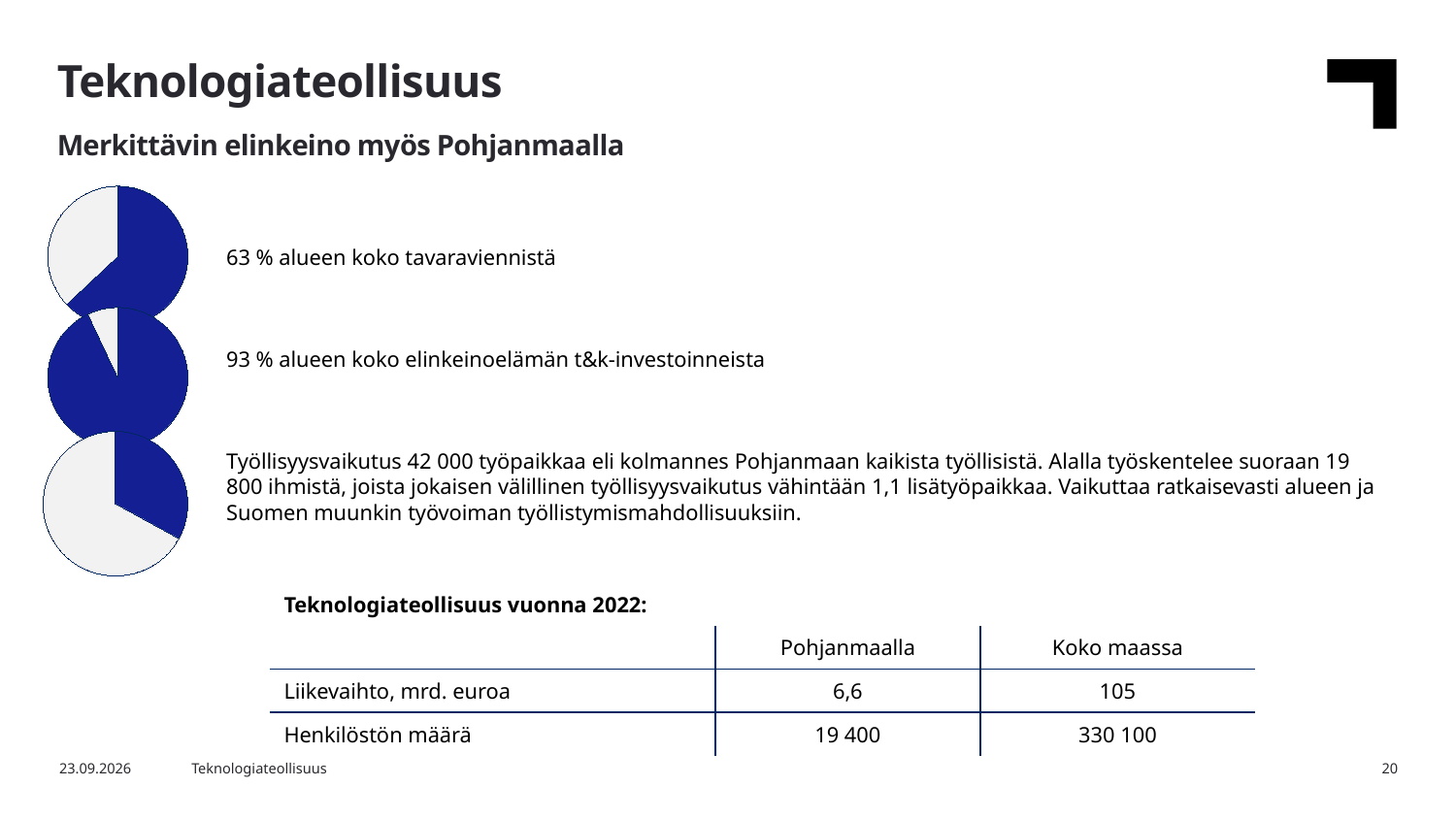
How many slices does each pie chart have? 2 Is the blue slice larger in the top pie chart or in the middle pie chart? The middle pie chart Which pie chart is described by the text about the employment effect of 42 000 jobs? The bottom pie chart What kind of charts are shown on the left side of the slide? Pie charts Is the blue slice larger in the top pie chart or in the bottom pie chart? The top pie chart In the middle pie chart, what share of the region's business R&D investments does the blue slice represent, according to the text beside it? 93 % How many pie charts are on the slide? 3 What is the difference between the blue share in the middle pie chart (93 %) and the blue share in the top pie chart (63 %)? 30 percentage points In the top pie chart, what share of the region's total goods exports does the blue slice represent, according to the text beside it? 63 % Which of the three pie charts has the smallest blue slice? The bottom pie chart Which of the three pie charts has the largest blue slice? The middle pie chart What colour is the highlighted slice in the pie charts? Dark blue